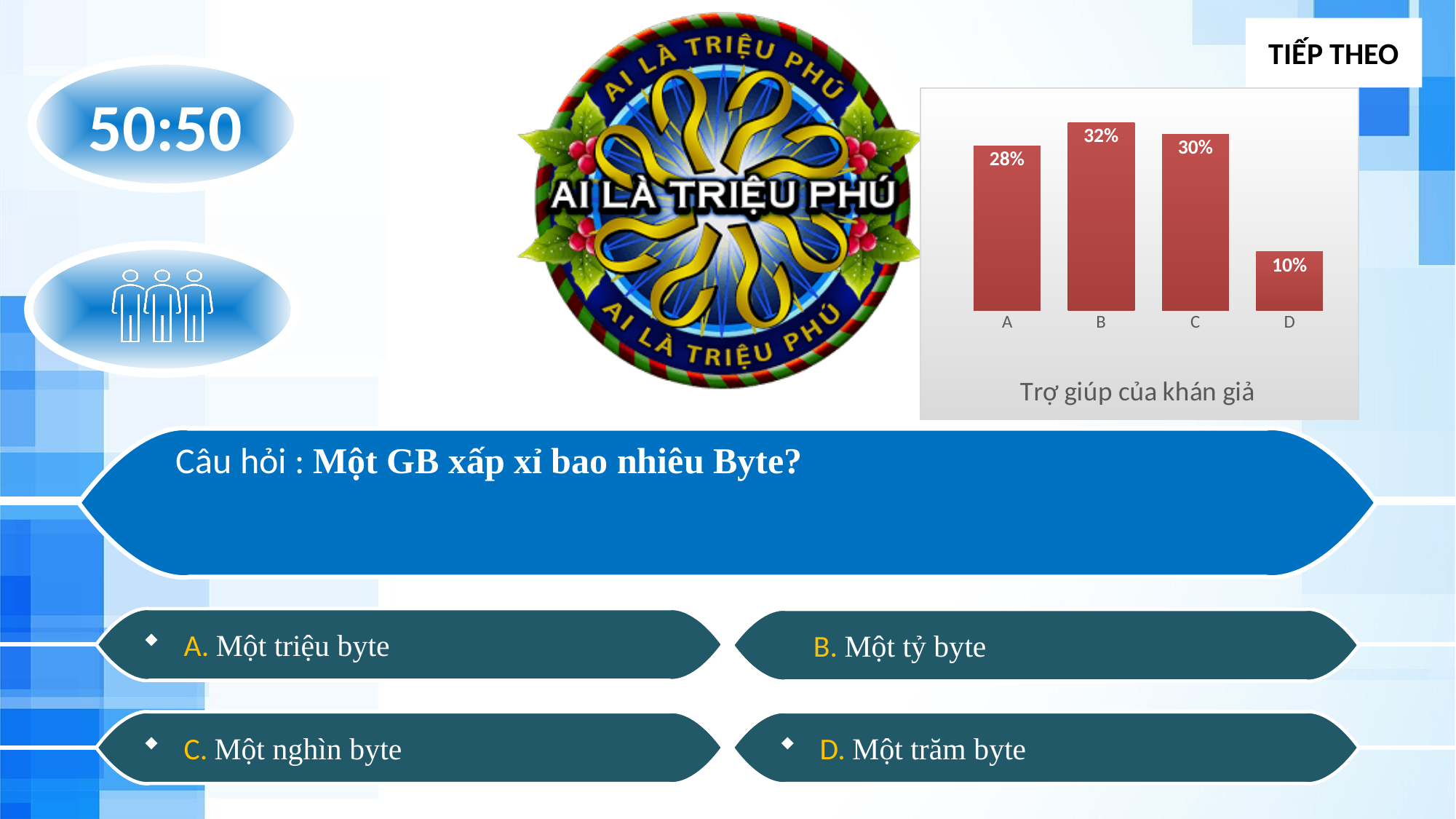
What kind of chart is the 'Trợ giúp của khán giả' chart? bar chart Which category has the lowest value in the 'Trợ giúp của khán giả' chart? D What is the difference between the values for B and D in the 'Trợ giúp của khán giả' chart? 22% What is the value for A in the 'Trợ giúp của khán giả' chart? 28% What is the difference between the values for C and A in the 'Trợ giúp của khán giả' chart? 2% How many categories are shown in the 'Trợ giúp của khán giả' chart? 4 Which is larger in the 'Trợ giúp của khán giả' chart, the value for A or the value for D? A What is the value for C in the 'Trợ giúp của khán giả' chart? 30% What is the value for D in the 'Trợ giúp của khán giả' chart? 10% What is the title of the chart on the slide? Trợ giúp của khán giả What is the value for B in the 'Trợ giúp của khán giả' chart? 32% Which category has the highest value in the 'Trợ giúp của khán giả' chart? B